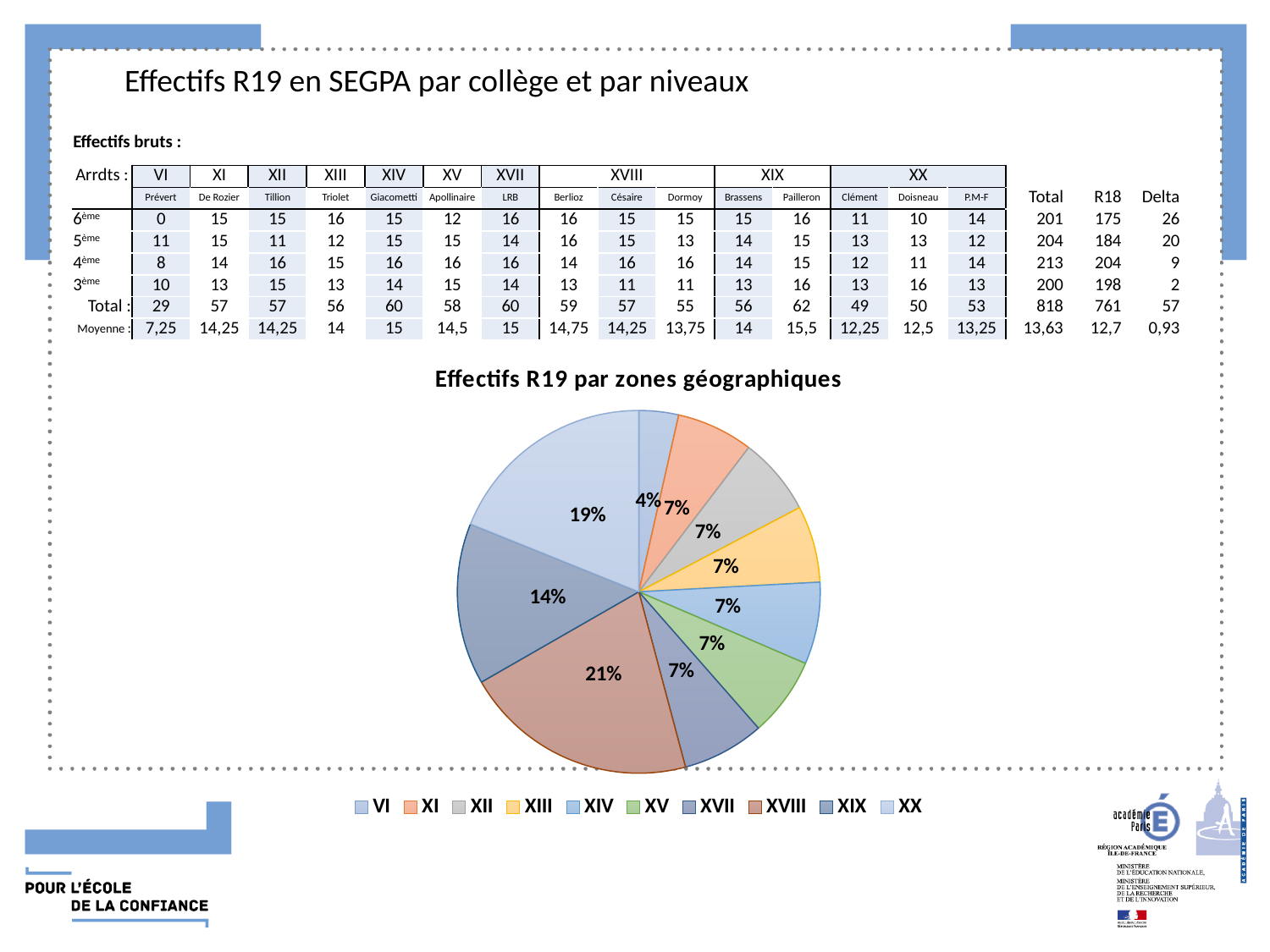
What share of the pie does XI represent? 7% What share of the pie does XVIII represent? 21% What is the title of the chart? Effectifs R19 par zones géographiques Which has the larger share, XX or XIX? XX What kind of chart is shown on the slide? pie chart Which zone has the largest slice of the pie? XVIII How many zones are listed in the chart legend? 10 What share of the pie does VI represent? 4% How many percentage points larger is the share of XVIII than the share of XIX? 7 Which zone has the smallest slice of the pie? VI What share of the pie does XIX represent? 14% What share of the pie does XX represent? 19%